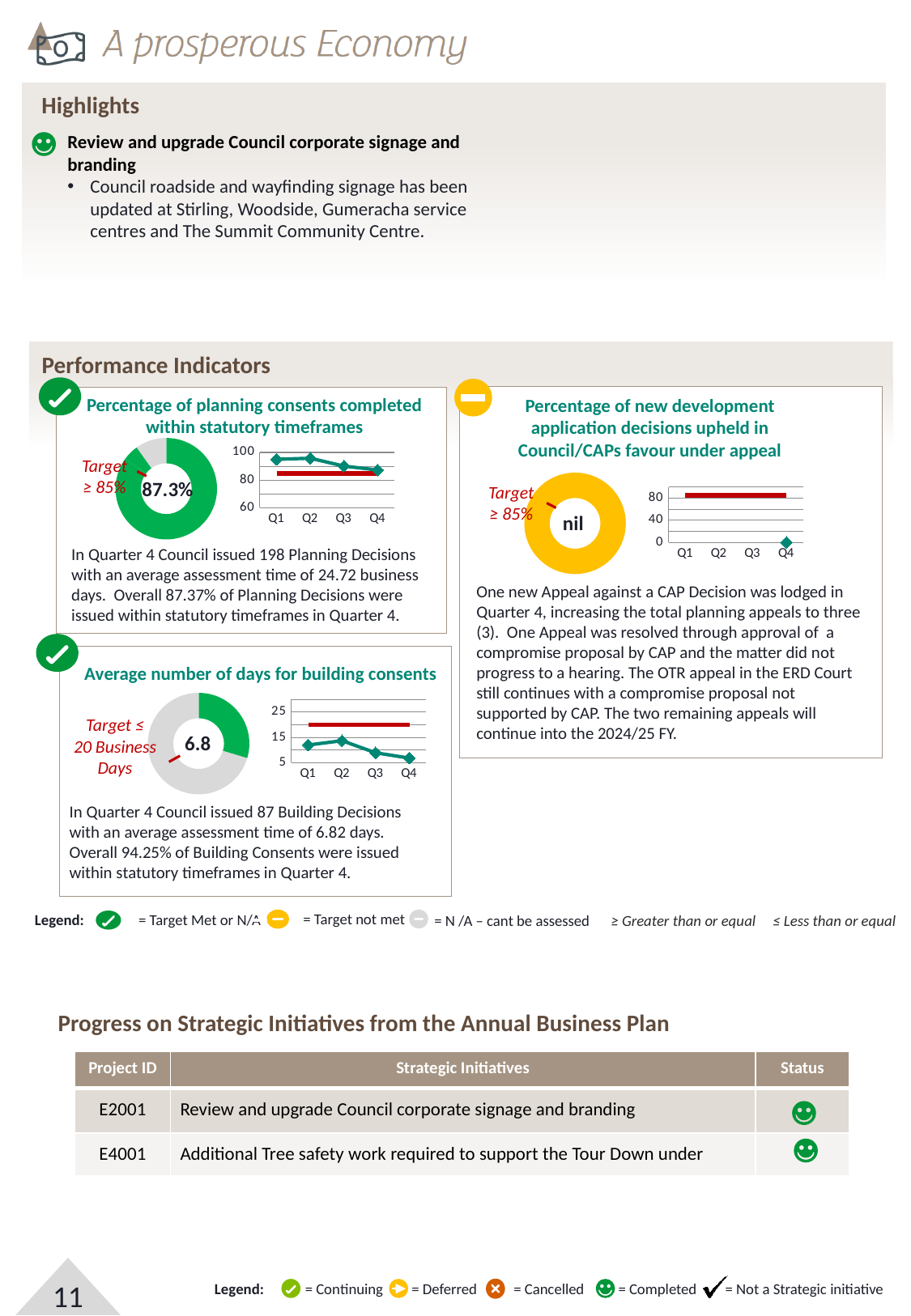
In the building consents line chart, do the values rise or fall from Q1 to Q4? fall What kind of chart displays the 87.3% value in the planning consents indicator? donut chart What kind of chart is the small quarterly chart beside the 'Average number of days for building consents' donut? line chart In the planning consents line chart, do the values rise or fall from Q1 to Q4? fall What target is stated beside the 'Average number of days for building consents' donut chart? ≤ 20 Business Days In the building consents line chart, is the value for Q4 greater or less than 15? less In the 'Average number of days for building consents' donut chart, what value is shown in the centre? 6.8 In the 'Percentage of new development application decisions upheld in Council/CAPs favour under appeal' donut chart, what value is shown in the centre? nil In the line chart next to the planning consents donut, how many quarters are plotted on the x axis? 4 In the building consents line chart, which quarter has the lowest value? Q4 In the planning consents line chart, is the value for Q1 greater or less than 80? greater In the 'Percentage of planning consents completed within statutory timeframes' donut chart, what value is shown in the centre? 87.3%